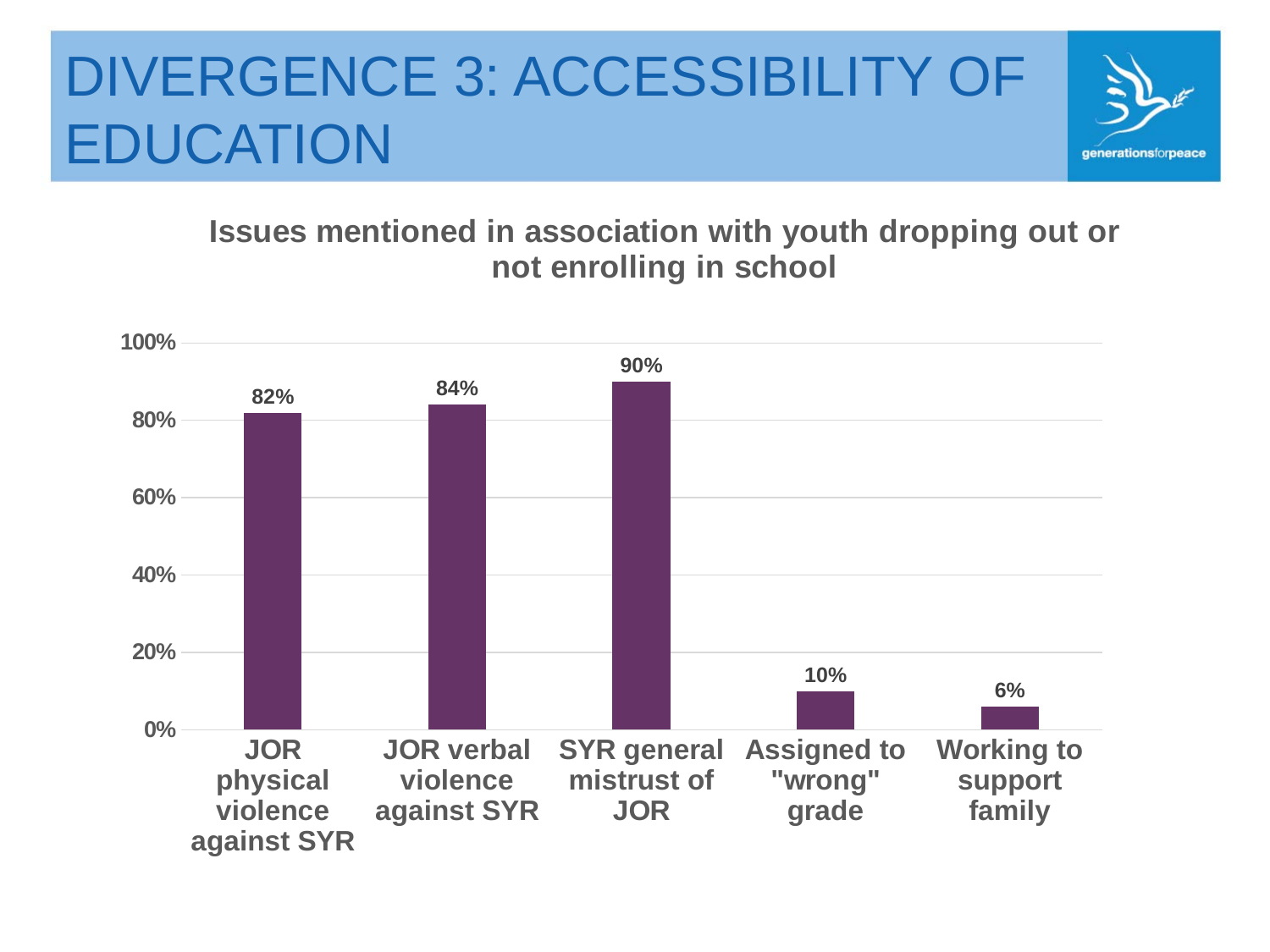
What is the value for "JOR verbal violence against SYR"? 84% What kind of chart is shown on the slide? Bar chart Which category has the highest value? SYR general mistrust of JOR What is the title of the chart? Issues mentioned in association with youth dropping out or not enrolling in school What is the value for "Working to support family"? 6% Which is larger, the value for "Assigned to "wrong" grade" or the value for "Working to support family"? Assigned to "wrong" grade How many categories are shown on the x axis? 5 What is the difference between the values for "SYR general mistrust of JOR" and "JOR physical violence against SYR"? 8% Which category has the lowest value? Working to support family What is the value for "SYR general mistrust of JOR"? 90% What is the value for "Assigned to "wrong" grade"? 10% Is the value for "JOR physical violence against SYR" greater or less than 80%? greater